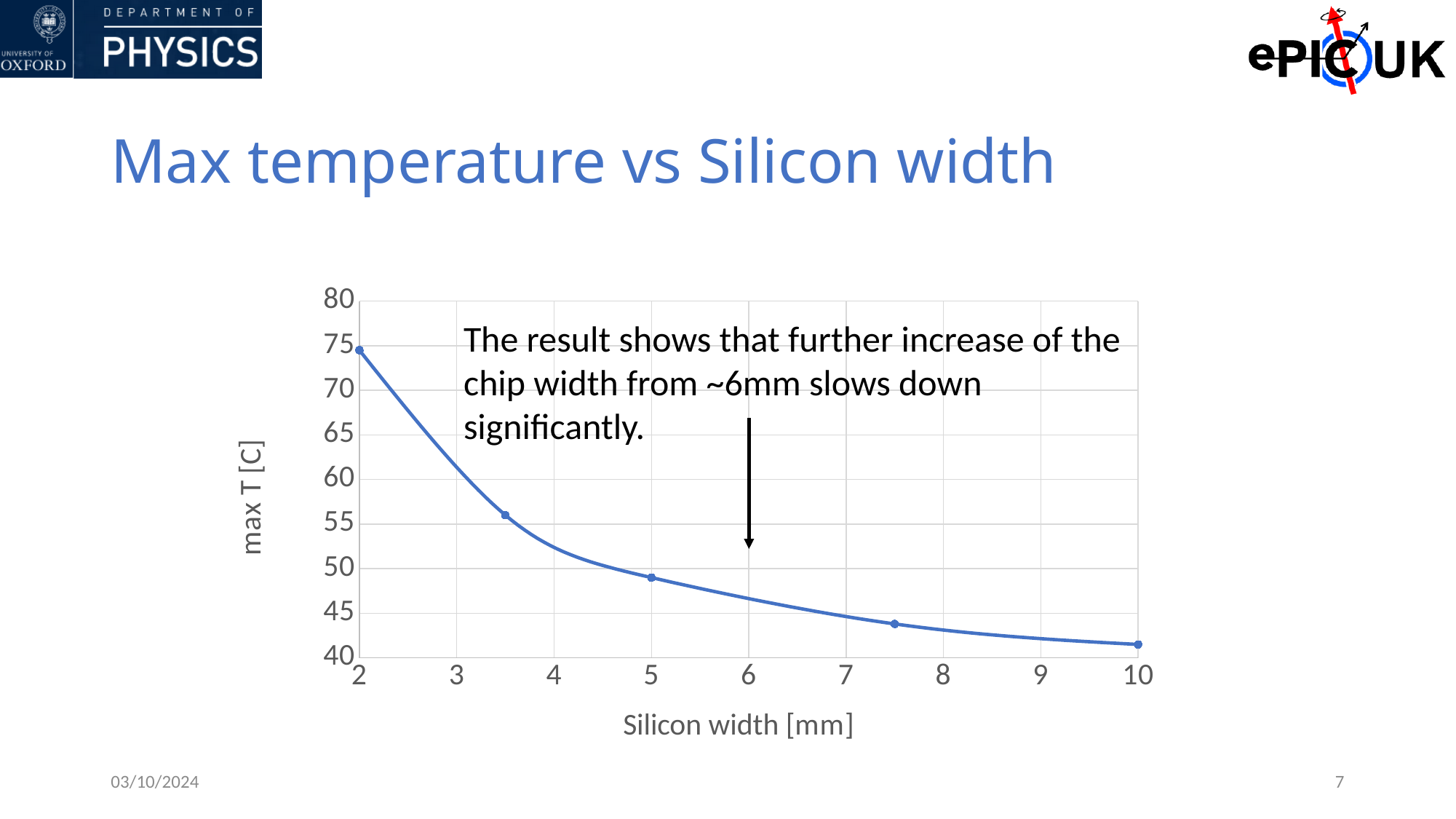
At which silicon width is max T highest? 2 mm What is the label of the x axis? Silicon width [mm] Is the max T at a silicon width of 2 mm greater or less than 70? greater Which has the higher max T: a silicon width of 3.5 mm or 7.5 mm? 3.5 mm Is the max T at a silicon width of 5 mm greater or less than 55? less Is the max T at a silicon width of 3.5 mm greater or less than 60? less Does max T rise or fall as silicon width increases along the x axis? fall At which silicon width is max T lowest? 10 mm How many data points are plotted on the line? 5 What is the label of the y axis? max T [C] What kind of chart is shown on the slide? line chart